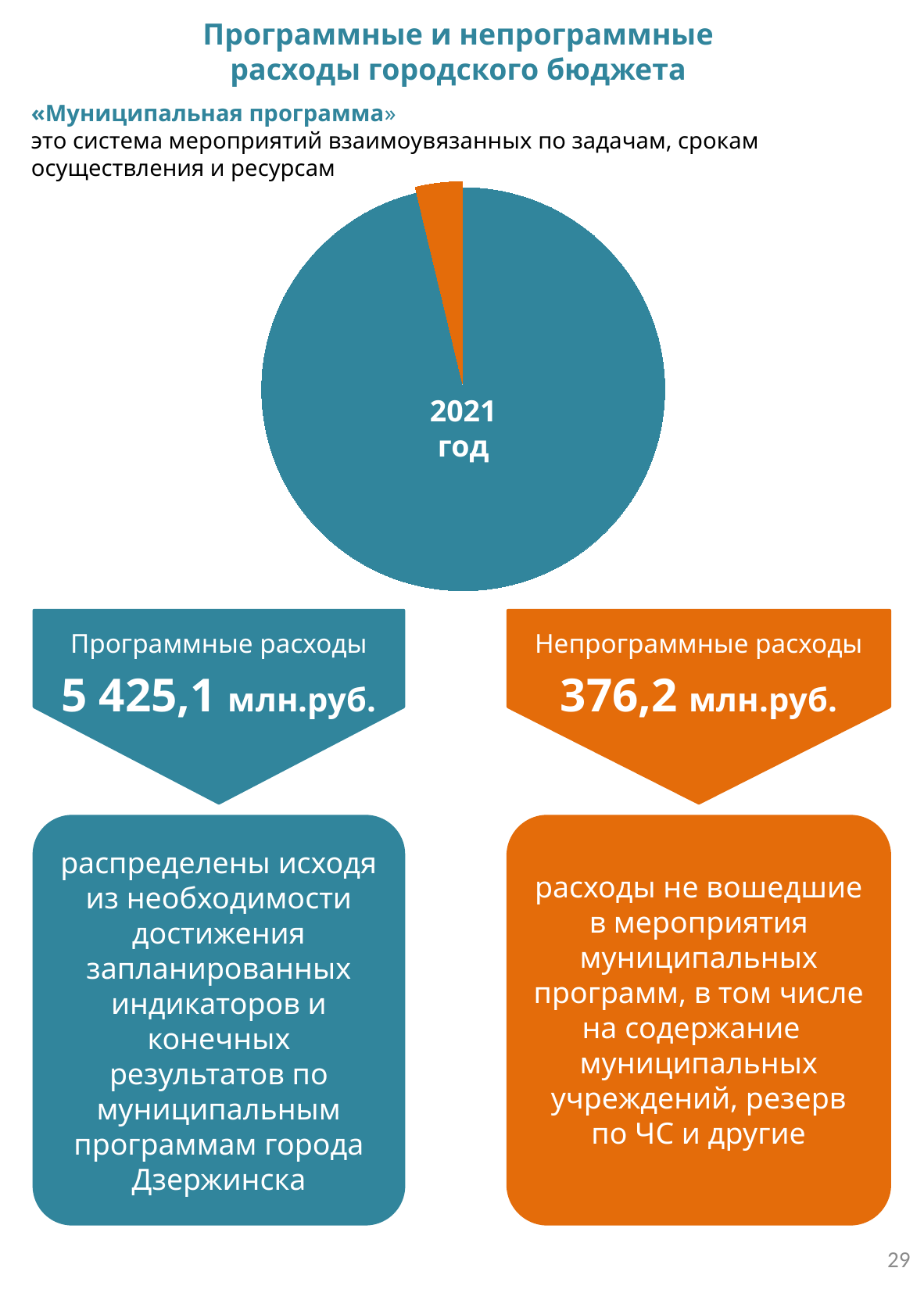
Which category takes the largest share of the pie chart? Программные расходы Which year is labelled in the centre of the pie chart? 2021 год What colour is the slice representing Непрограммные расходы? orange Which is larger, Программные расходы or Непрограммные расходы? Программные расходы Is the value for Непрограммные расходы greater or less than 1 000 млн.руб.? less How many slices does the pie chart have? 2 Which category takes the smallest share of the pie chart? Непрограммные расходы What is the value of Программные расходы? 5 425,1 млн.руб. What is the total of Программные расходы and Непрограммные расходы? 5 801,3 млн.руб. What is the difference between Программные расходы and Непрограммные расходы? 5 048,9 млн.руб. What is the value of Непрограммные расходы? 376,2 млн.руб. What kind of chart is shown on the slide? pie chart